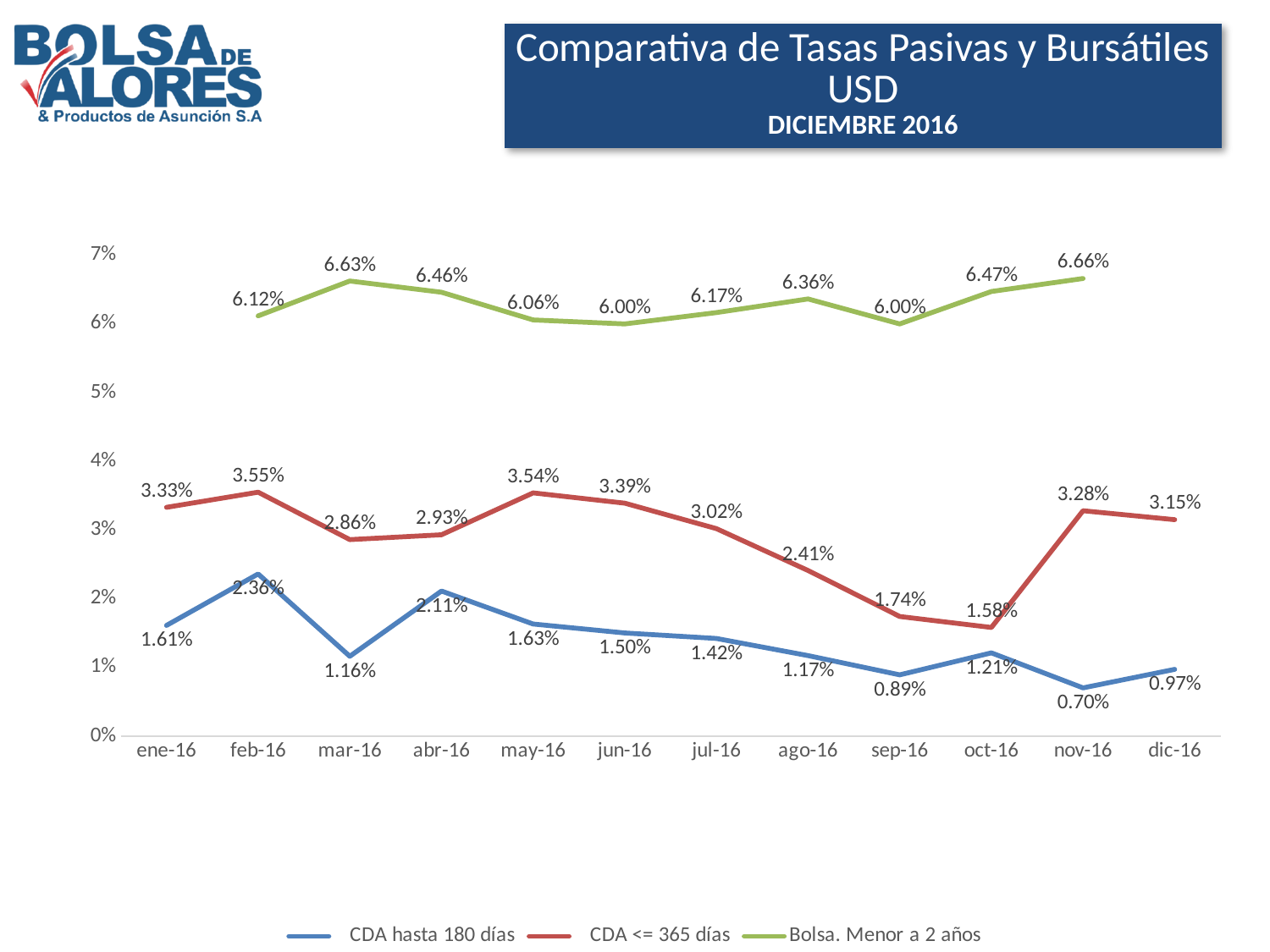
In which month is CDA hasta 180 días at its lowest? nov-16 What is the value for Bolsa. Menor a 2 años in oct-16? 6.47% In which month is CDA hasta 180 días at its highest? feb-16 In which month is CDA <= 365 días at its lowest? oct-16 Which is larger in sep-16: CDA <= 365 días or CDA hasta 180 días? CDA <= 365 días Does CDA <= 365 días rise or fall from jun-16 to oct-16? fall What is the value for CDA hasta 180 días in mar-16? 1.16% What is the difference between CDA <= 365 días and CDA hasta 180 días in dic-16? 2.18% How many months are shown on the x axis? 12 What is the value for CDA <= 365 días in ago-16? 2.41% How many series does the legend list? 3 What type of chart is shown on the slide? line chart